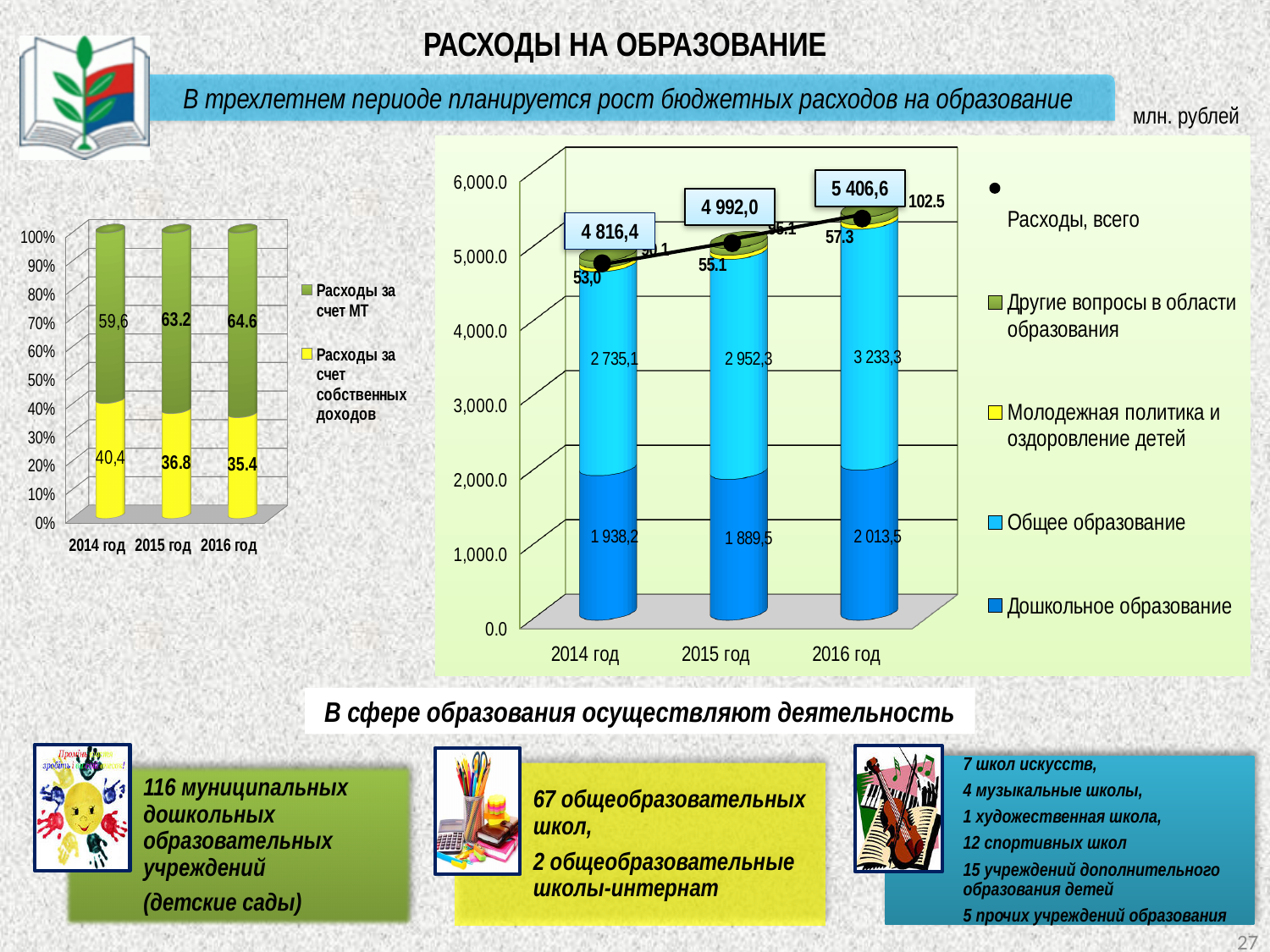
In the right chart, is the value of 'Общее образование' for 2016 год greater or less than 3,000.0? greater In the left chart, what is the value of 'Расходы за счет собственных доходов' for 2014 год? 40,4 In the left chart, how many series does the legend list? 2 In the left chart, does the share of 'Расходы за счет собственных доходов' rise or fall from 2014 год to 2016 год? fall In the right chart, what is the total 'Расходы, всего' for 2016 год? 5 406,6 In the right chart, how many years are shown on the x axis? 3 In the left chart, what is the value of 'Расходы за счет МТ' for 2016 год? 64.6 In the right chart, which year has the highest 'Расходы, всего'? 2016 год In the right chart, what is the value of 'Дошкольное образование' for 2014 год? 1 938,2 In the right chart, which year has the lowest value for 'Дошкольное образование'? 2015 год In the right chart, what is the difference between 'Расходы, всего' for 2016 год and 2015 год? 414,6 In the right chart, what is the value of 'Общее образование' for 2015 год? 2 952,3